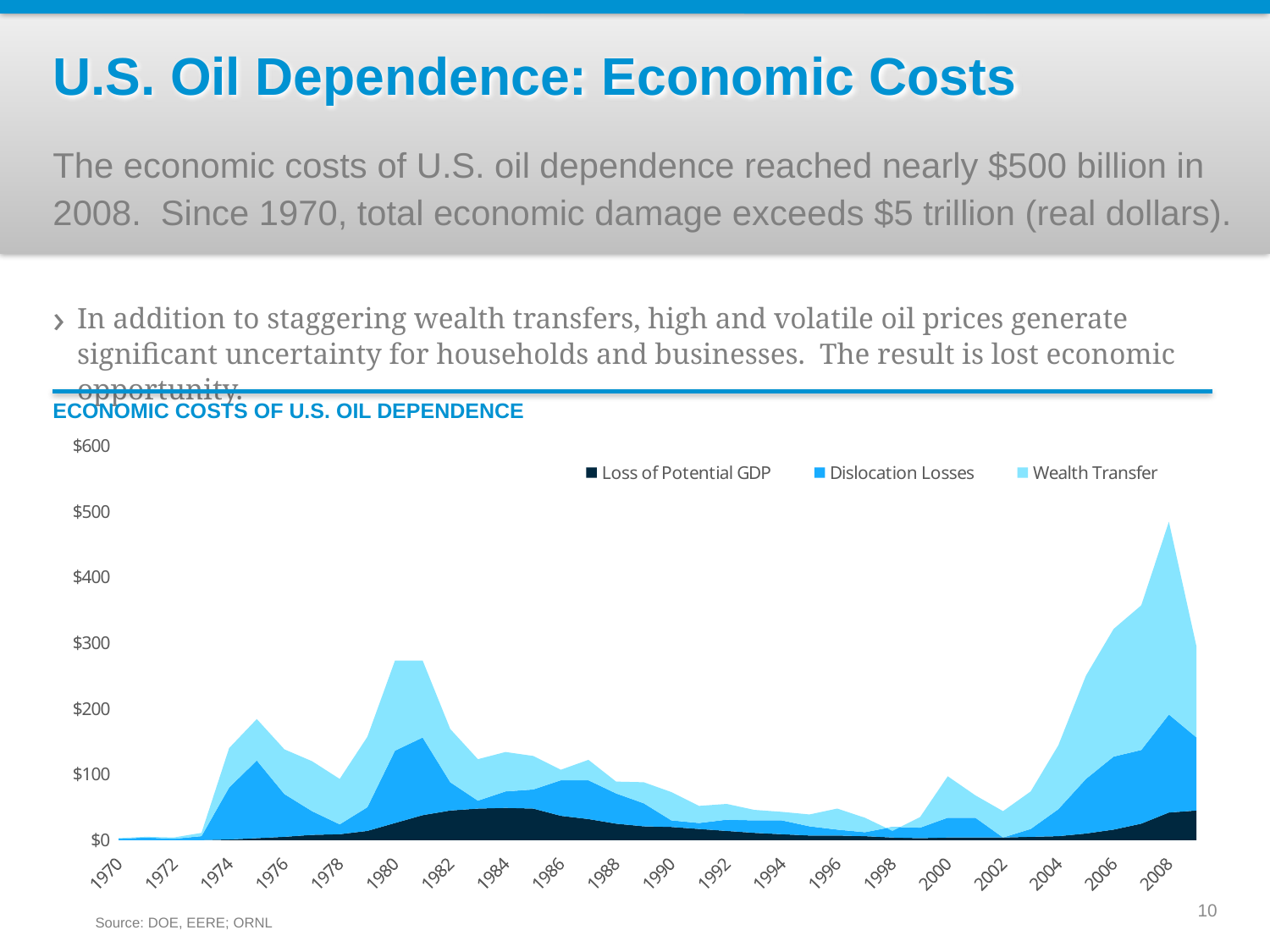
Which year has the larger total economic cost, 1980 or 2008? 2008 Do the total economic costs rise or fall between 2002 and 2008? Rise Is the total economic cost in 1990 greater or less than $100? less Which year has the larger total economic cost, 1974 or 1980? 1980 Is the total economic cost in 1998 greater or less than $100? less Which series is shown in the lightest blue at the top of the stacked areas? Wealth Transfer Is the total economic cost in 1980 greater or less than $200? greater What kind of chart is shown on the slide? Stacked area chart In which year does the total economic cost reach its highest point? 2008 What is the title of the chart? ECONOMIC COSTS OF U.S. OIL DEPENDENCE How many series does the chart legend list? 3